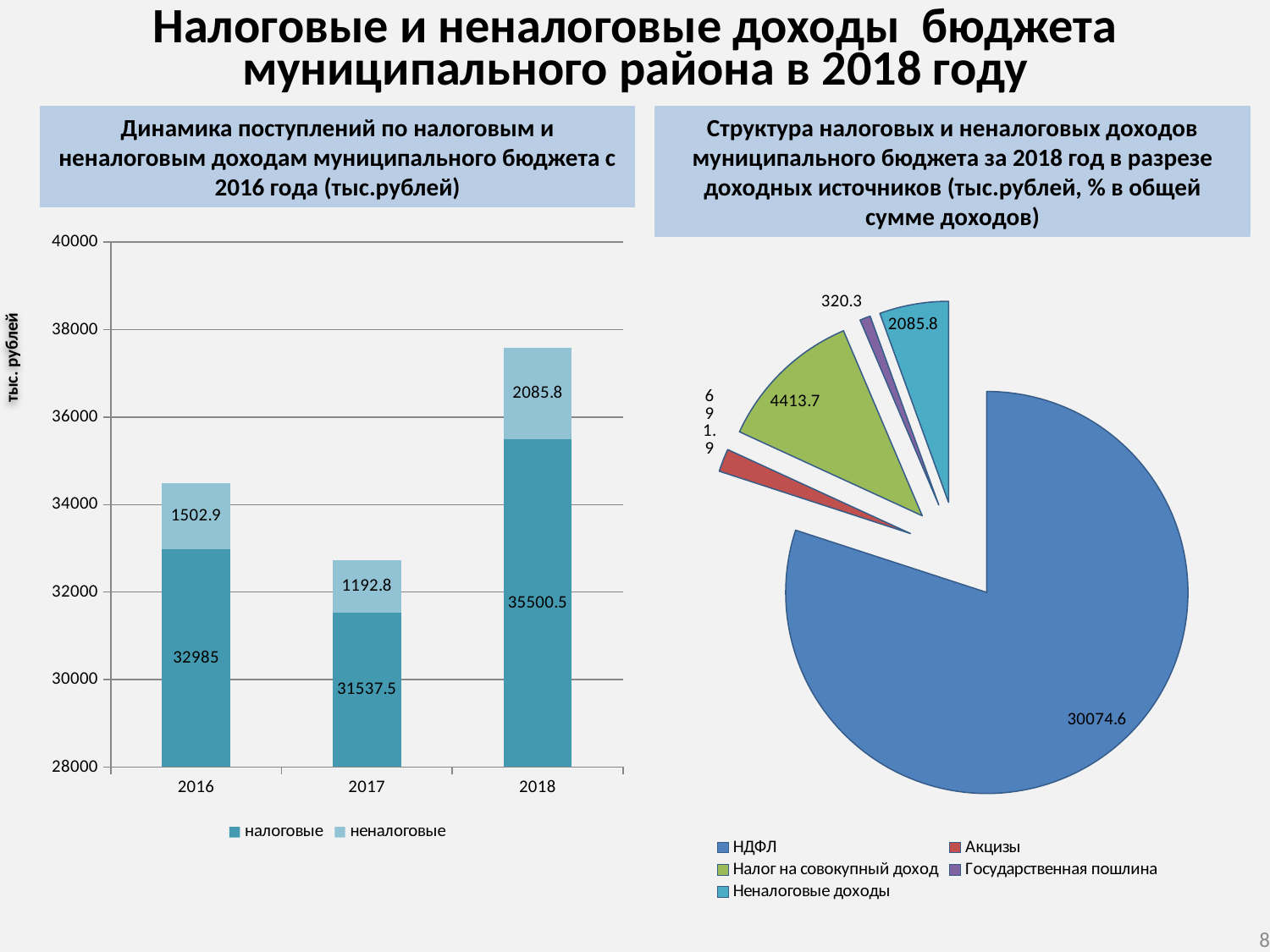
In the left bar chart, how many series does the legend list? 2 In the left bar chart, which year has the highest value for налоговые? 2018 What kind of chart is the left chart? Stacked bar chart In the right pie chart, how many categories does the legend list? 5 In the right pie chart, what is the value for Налог на совокупный доход? 4413.7 In the right pie chart, which is larger: Неналоговые доходы or Государственная пошлина? Неналоговые доходы In the left bar chart, what is the value of неналоговые for 2017? 1192.8 In the left bar chart, what is the difference between налоговые in 2018 and налоговые in 2017? 3963 In the left bar chart, what is the value of налоговые for 2018? 35500.5 In the left bar chart, what is the total of the stacked bar for 2016? 34487.9 In the right pie chart, which category has the largest slice? НДФЛ In the left bar chart, which year has the lowest value for неналоговые? 2017